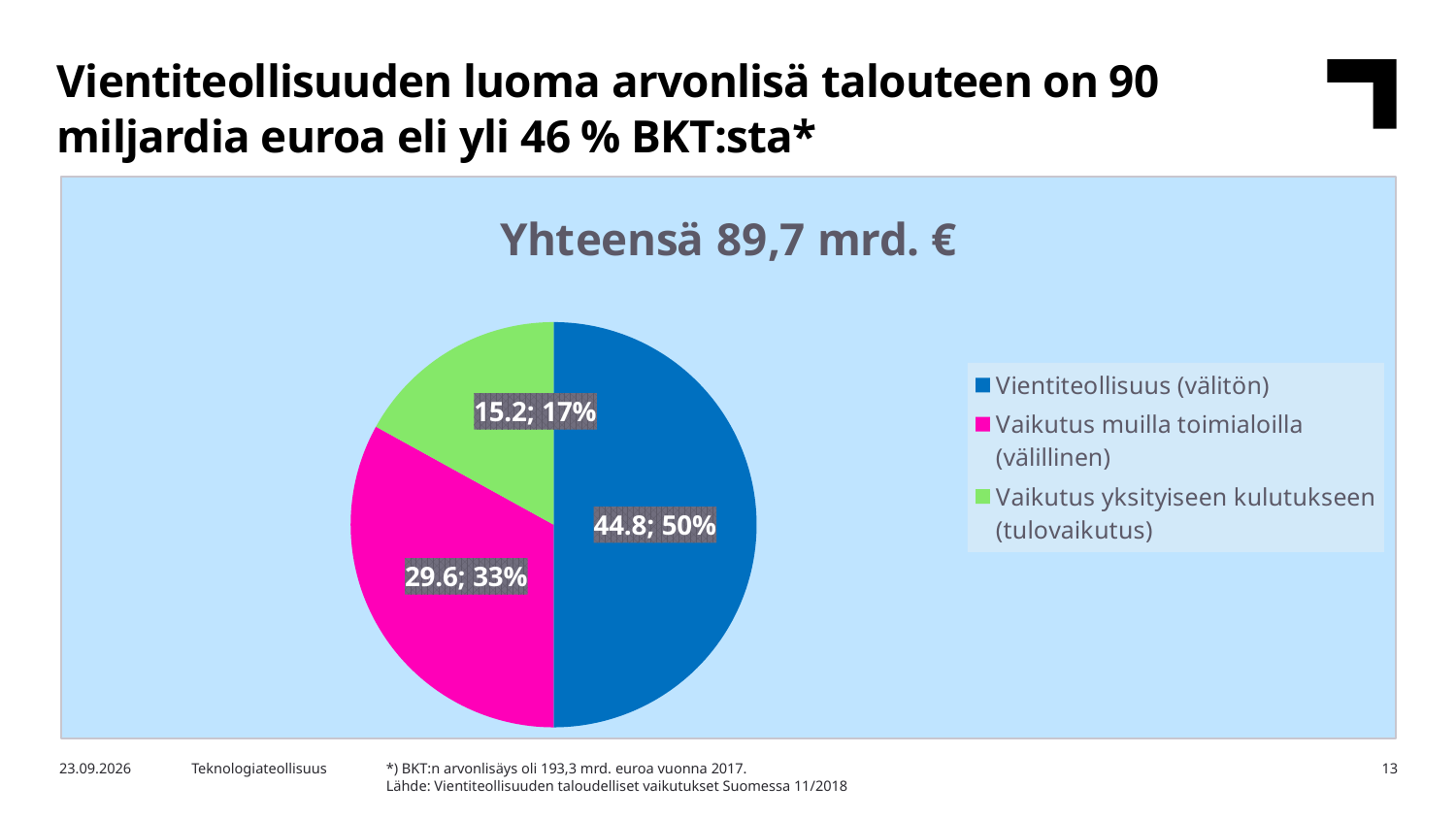
What is the difference between the values for Vientiteollisuus (välitön) and Vaikutus muilla toimialoilla (välillinen)? 15.2 What share of the pie does Vaikutus yksityiseen kulutukseen (tulovaikutus) represent? 17% What value is shown for Vaikutus muilla toimialoilla (välillinen)? 29.6 What value is shown for Vientiteollisuus (välitön)? 44.8 What is the title of the chart? Yhteensä 89,7 mrd. € What kind of chart is shown on the slide? Pie chart Which slice is the largest? Vientiteollisuus (välitön) How many slices does the pie chart have? 3 How many entries does the legend list? 3 Which slice is the smallest? Vaikutus yksityiseen kulutukseen (tulovaikutus) What share of the pie does Vientiteollisuus (välitön) represent? 50% What value is shown for Vaikutus yksityiseen kulutukseen (tulovaikutus)? 15.2